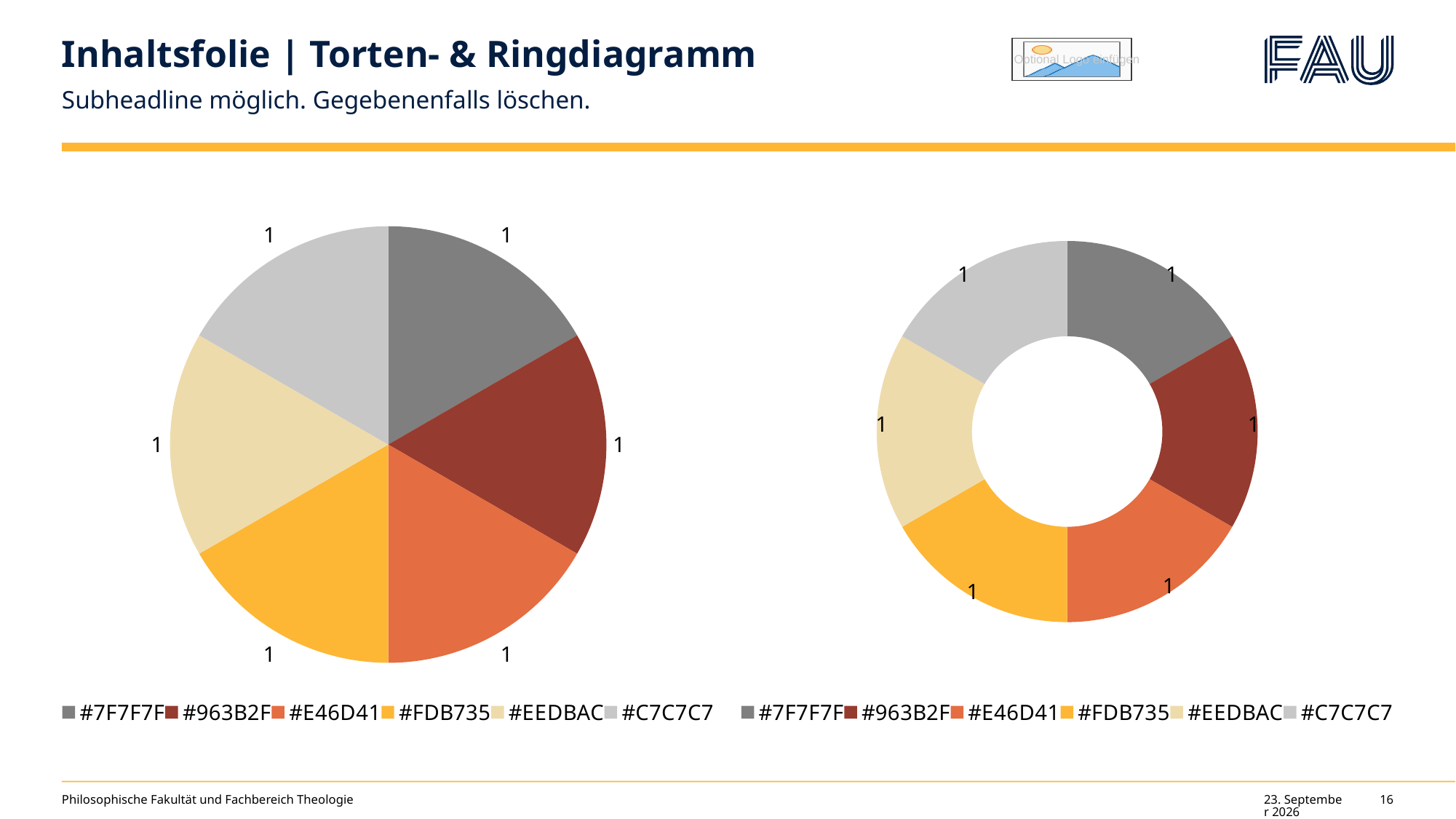
In the pie chart on the left, how many slices are there? 6 In the pie chart on the left, what is the total of all slice values? 6 What type of chart is the chart on the left side of the slide? pie chart In the pie chart on the left, what is the value of the #FDB735 slice? 1 In the doughnut chart on the right, what is the total of all segment values? 6 How many entries does the legend of the pie chart on the left list? 6 What type of chart is the chart on the right side of the slide? doughnut chart In the doughnut chart on the right, which legend entry is shown in orange? #E46D41 In the pie chart on the left, what is the value of the #7F7F7F slice? 1 In the doughnut chart on the right, what is the value of the #C7C7C7 segment? 1 In the doughnut chart on the right, how many segments are there? 6 In the doughnut chart on the right, what is the value of the #963B2F segment? 1